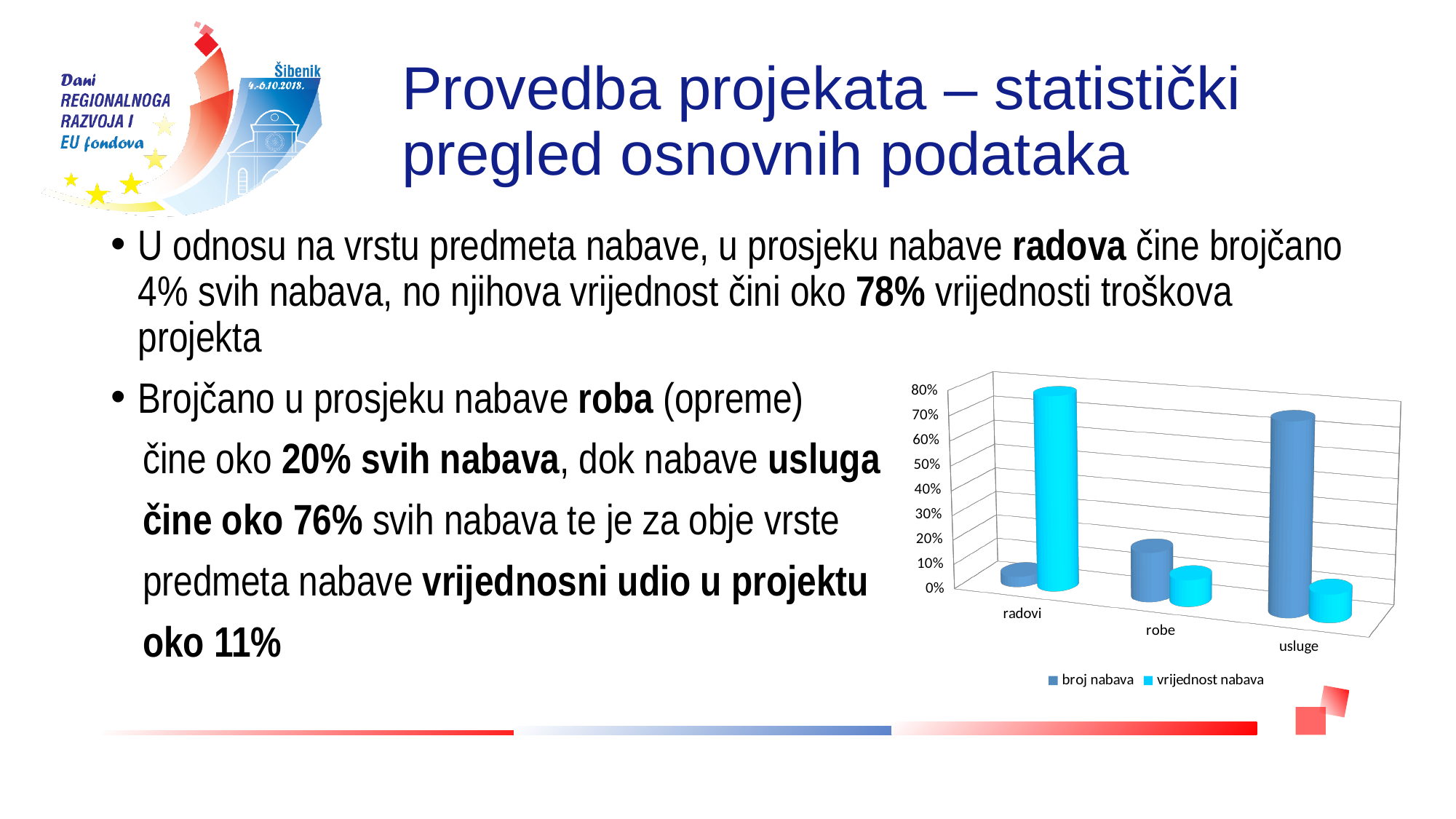
Which category has the lowest value for the series 'broj nabava'? radovi What are the two series names listed in the chart legend? broj nabava, vrijednost nabava Is the value of 'broj nabava' for 'radovi' greater or less than 10%? less Which category has the highest value for the series 'broj nabava'? usluge How many categories are shown on the x axis of the chart? 3 Is the value of 'broj nabava' for 'usluge' greater or less than 60%? greater Is the value of 'vrijednost nabava' for 'radovi' greater or less than 70%? greater Which category has the highest value for the series 'vrijednost nabava'? radovi For the category 'radovi', which series has the larger value: 'broj nabava' or 'vrijednost nabava'? vrijednost nabava For the category 'usluge', which series has the larger value: 'broj nabava' or 'vrijednost nabava'? broj nabava What kind of chart is shown on the slide? bar chart How many series does the chart legend list? 2